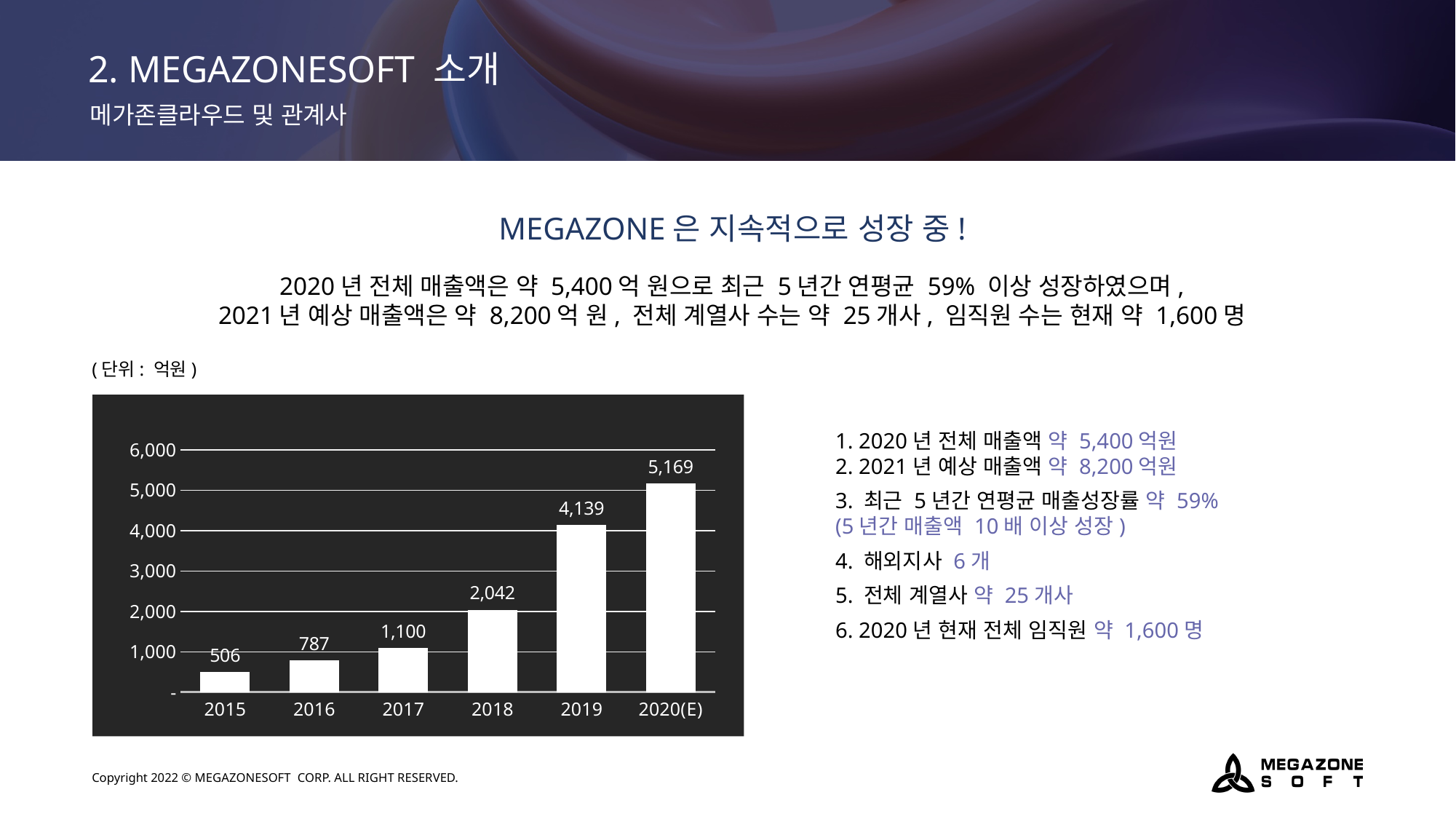
What is the value for 2020(E) in the bar chart? 5,169 Which year has the lowest value in the bar chart? 2015 What kind of chart is shown on the slide? bar chart What is the difference between the values for 2017 and 2016? 313 What is the value for 2018 in the bar chart? 2,042 Which year has the highest value in the bar chart? 2020(E) How many years are shown on the x axis of the bar chart? 6 Is the value for 2019 greater or less than 4,000? greater Which is larger, the value for 2017 or the value for 2016? 2017 What is the value for 2015 in the bar chart? 506 What is the difference between the values for 2019 and 2018? 2,097 Do the values rise or fall from 2015 to 2020(E)? rise